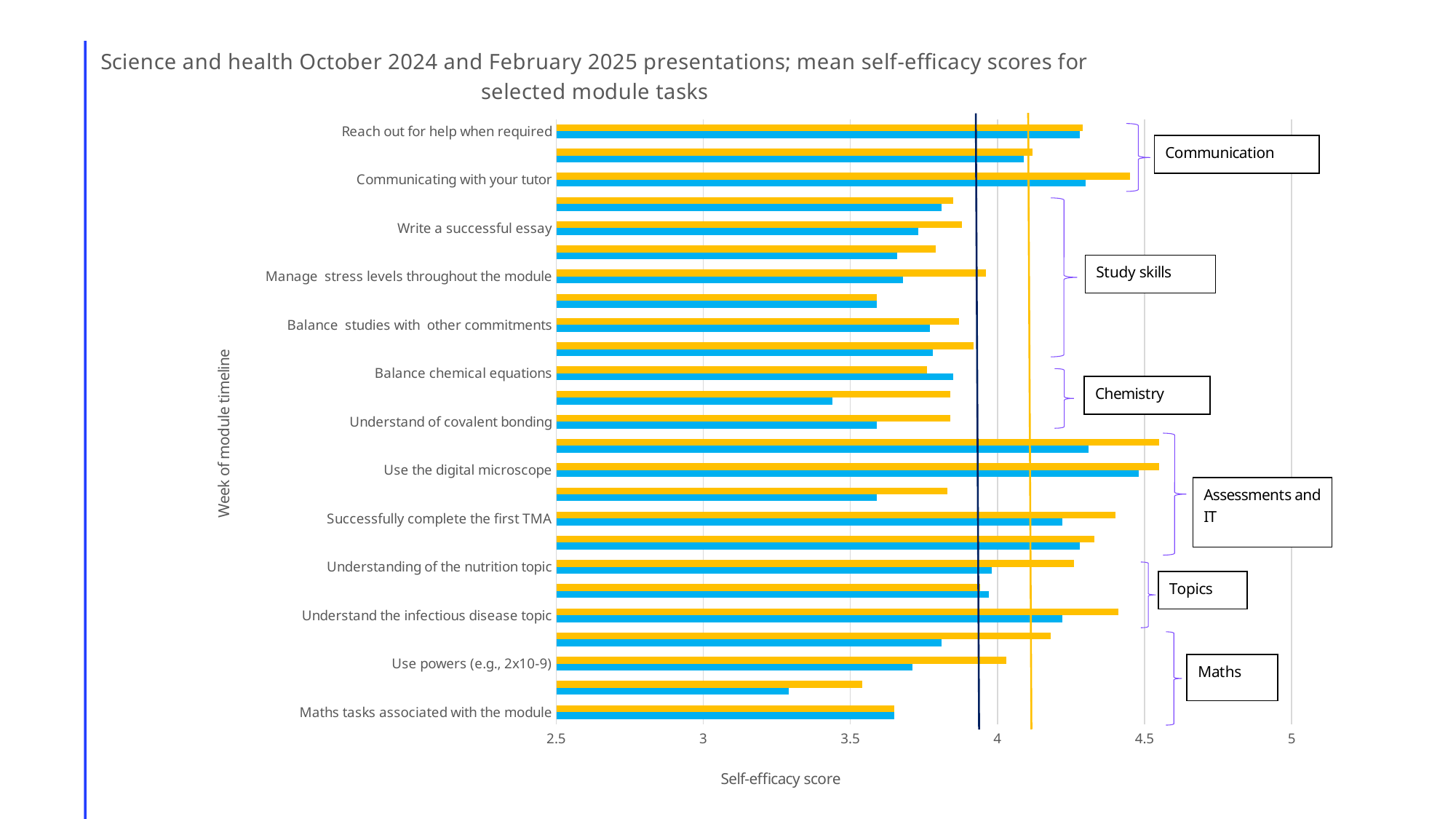
Is the yellow bar for "Understand the infectious disease topic" greater or less than 4? greater Is the yellow bar for "Write a successful essay" greater or less than 4? less Is the yellow bar for "Communicating with your tutor" greater or less than 4? greater What is the label on the horizontal axis of the chart? Self-efficacy score For "Use powers (e.g., 2x10-9)", which bar is longer, the yellow bar or the blue bar? The yellow bar What is the title of the chart? Science and health October 2024 and February 2025 presentations; mean self-efficacy scores for selected module tasks What kind of chart is shown on the slide? Bar chart For "Understand of covalent bonding", which bar is longer, the yellow bar or the blue bar? The yellow bar